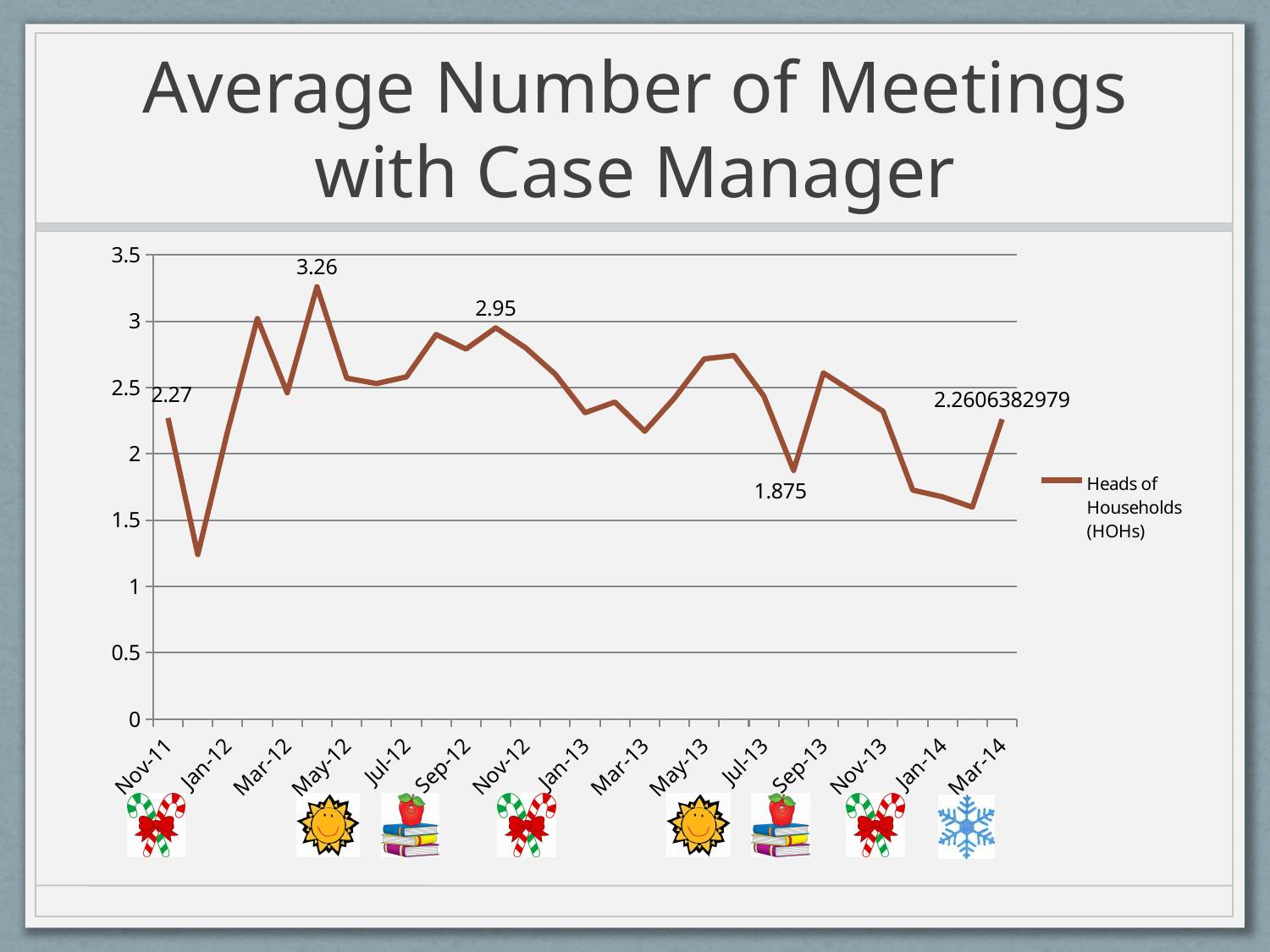
Which is larger, the value for Nov-11 or the value for Mar-14? Nov-11 What is the value for Mar-14? 2.2606382979 What is the highest value shown on the line? 3.26 What series name is shown in the legend? Heads of Households (HOHs) Is the value for Jan-14 greater or less than 2? less Is the lowest value on the line greater or less than 1.5? less What is the difference between the highest labeled value (3.26) and the value for Nov-11? 0.99 How many month labels are shown on the x axis? 15 How many series does the legend list? 1 What type of chart is shown on the slide? line chart Is the value for Nov-13 greater or less than 3? less What is the value for Nov-11? 2.27